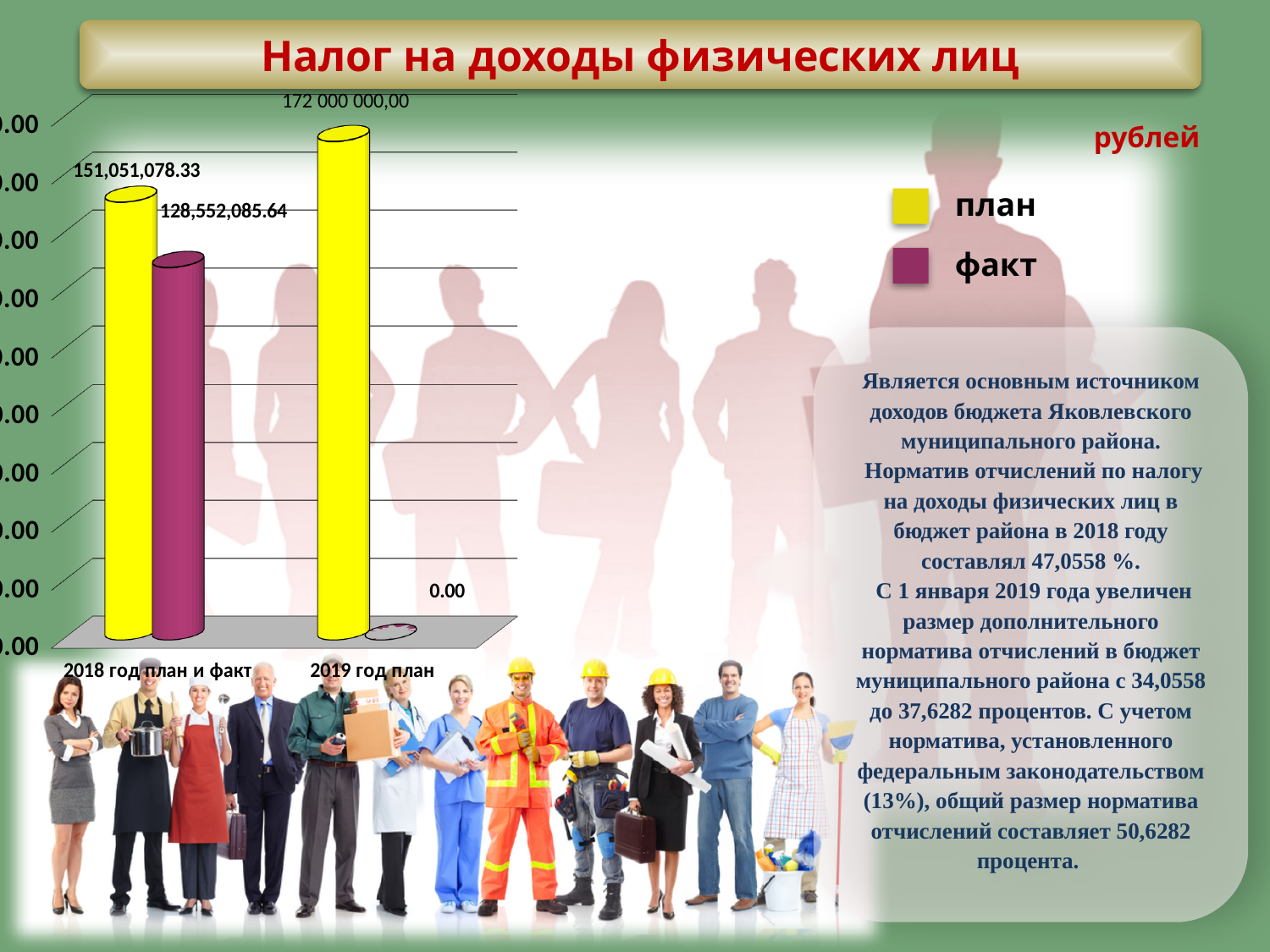
What is the actual (факт) value for 2018 (2018 год план и факт)? 128,552,085.64 Which category has the highest plan (план) value? 2019 год план Which colour represents the план (plan) series in the legend? yellow Which is larger for 2018: the plan (план) or the actual (факт) value? план What is the difference between the 2018 plan (план) and the 2018 actual (факт) values? 22,498,992.69 What is the actual (факт) value shown for 2019 (2019 год план)? 0.00 What kind of chart is shown on the slide? bar chart What is the plan (план) value for 2019 (2019 год план)? 172 000 000,00 What is the plan (план) value for 2018 (2018 год план и факт)? 151,051,078.33 How many series does the legend list? 2 How many categories are shown on the x axis of the chart? 2 What is the difference between the 2019 plan and the 2018 plan values? 20,948,921.67